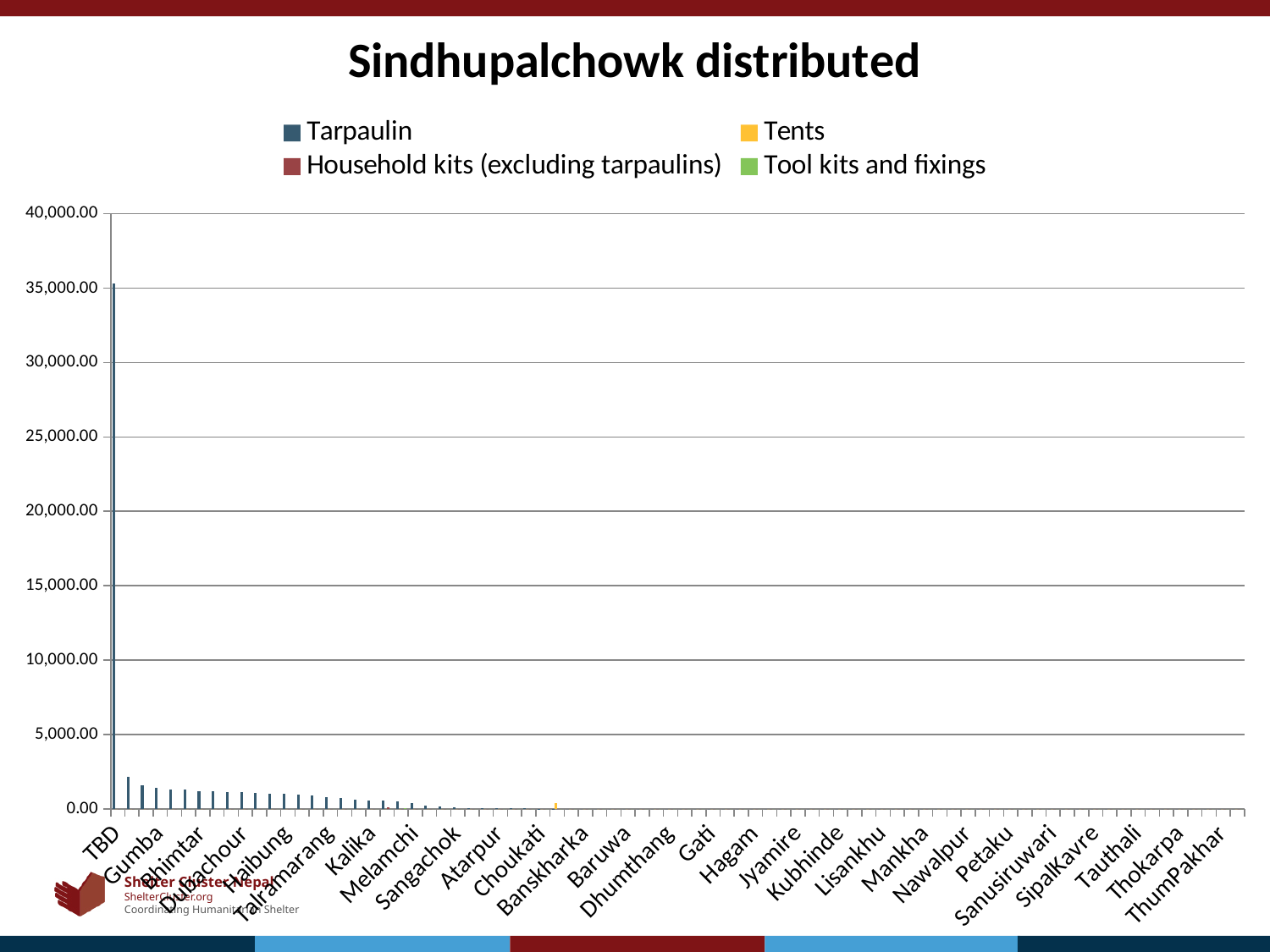
Is the Tarpaulin value for Gumba greater or less than 5,000.00? less What is the title of the chart? Sindhupalchowk distributed How many series does the legend list? 4 Do the Tarpaulin values generally rise or fall moving from left to right along the x axis? fall Which legend entry is shown in yellow? Tents Is the Tarpaulin value for TBD greater or less than 30,000.00? greater Which has the larger Tarpaulin value, TBD or Gumba? TBD Which category has the highest Tarpaulin value? TBD What is the highest value shown on the y axis? 40,000.00 What kind of chart is shown on the slide? bar chart Which has the larger Tarpaulin value, Gumba or Kalika? Gumba Is the Tarpaulin value for TBD greater or less than 40,000.00? less